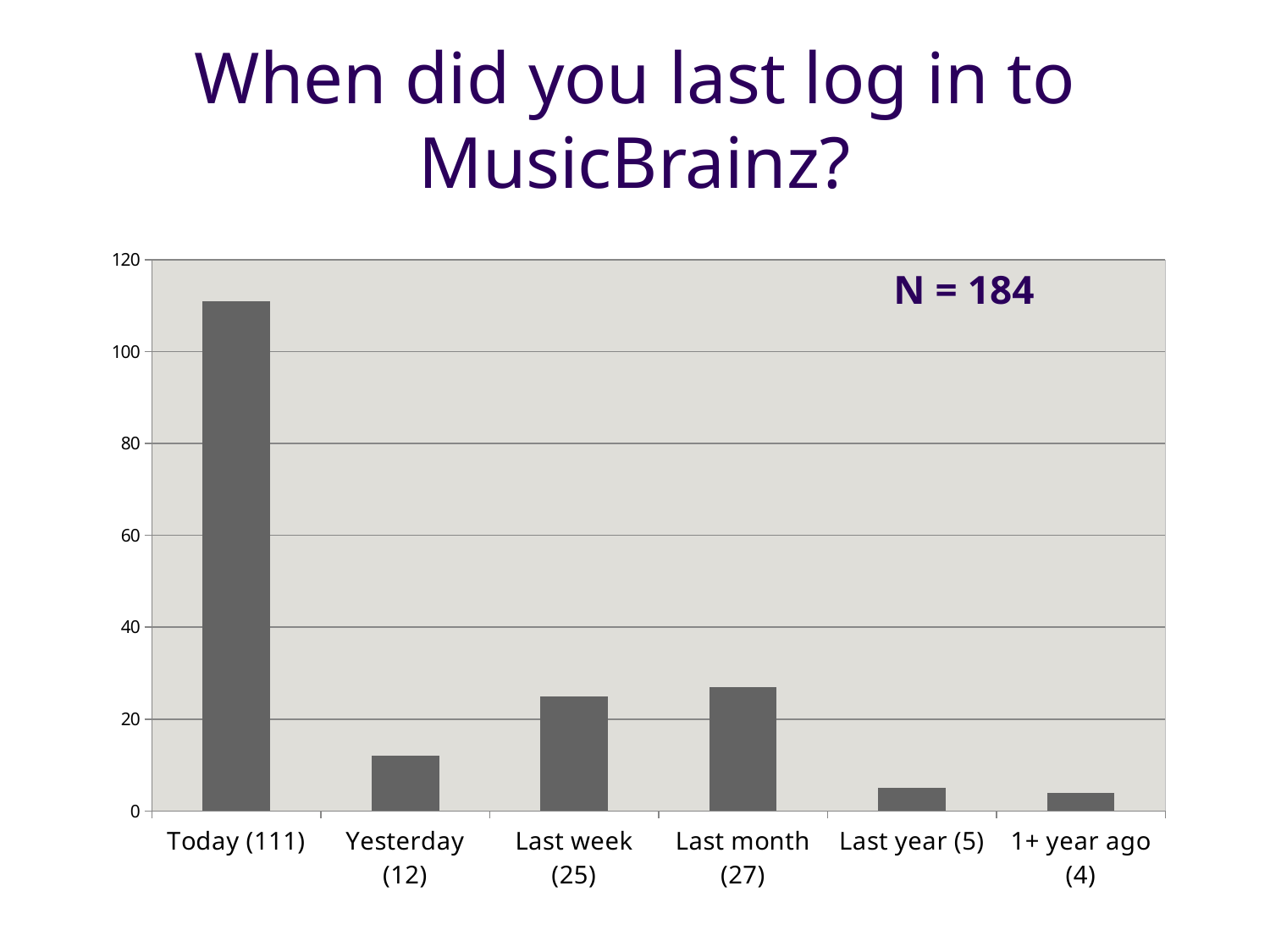
What is the total number of respondents (N) stated on the chart? 184 How many categories are shown on the x axis? 6 Which category has the highest value? Today What is the difference between the values for 'Last year' and '1+ year ago'? 1 Which is larger, the value for 'Last week' or the value for 'Yesterday'? Last week What kind of chart is shown on the slide? bar chart Is the value for 'Today' greater or less than 100? greater What is the value for 'Last month'? 27 How many respondents last logged in to MusicBrainz today? 111 What is the difference between the values for 'Today' and 'Last month'? 84 Which category has the lowest value? 1+ year ago How many respondents last logged in yesterday? 12